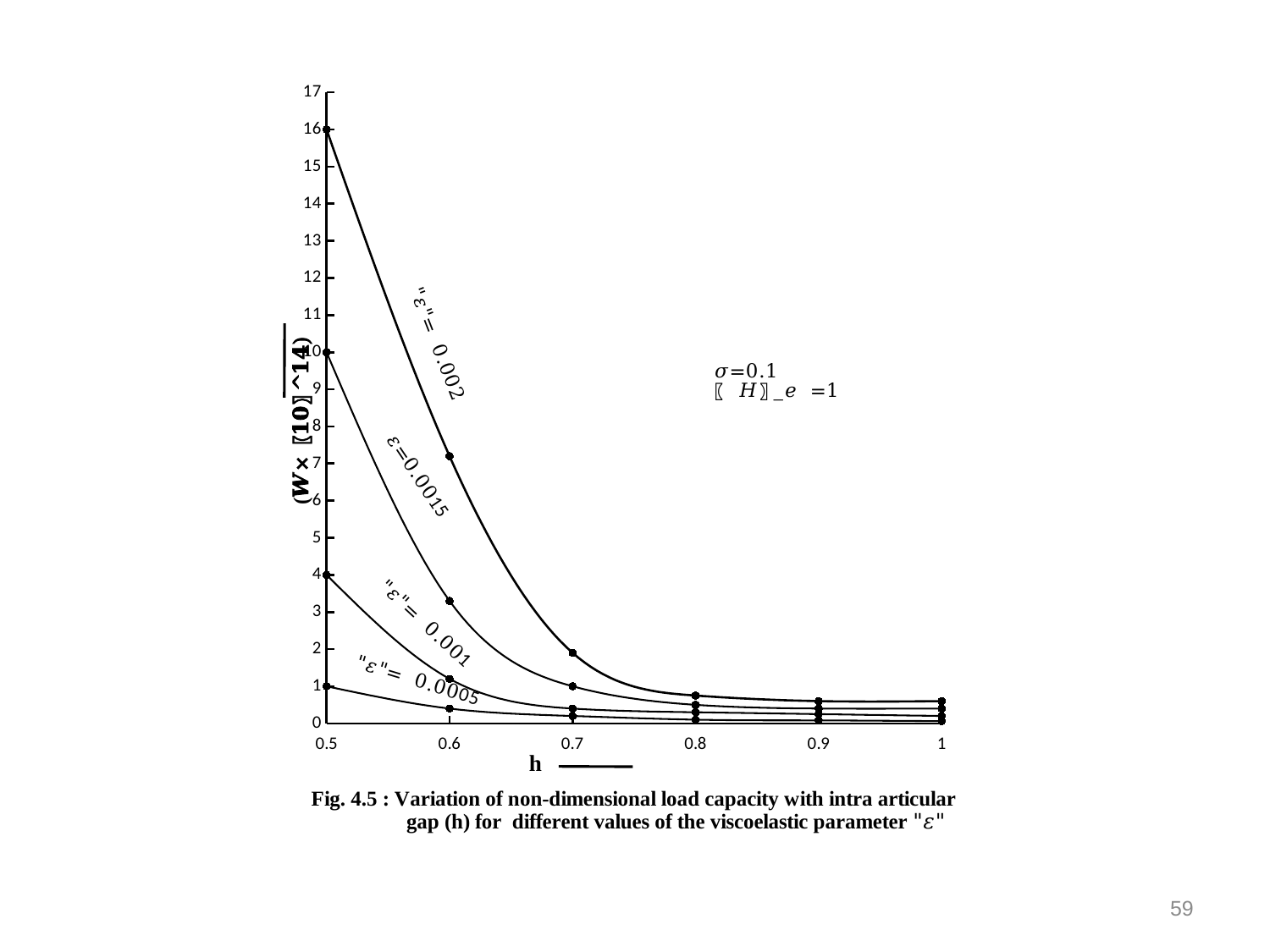
What is the value of the ε = 0.002 curve at h = 0.5? 16 Is the value of the ε = 0.002 curve at h = 0.6 greater or less than 5? greater At h = 0.6, which curve has the larger value, ε = 0.002 or ε = 0.001? ε = 0.002 Which curve has the highest value at h = 0.5? ε = 0.002 How many h values are marked along the x axis? 6 Do the curves rise or fall as h increases from 0.5 to 1? fall What is the value of the ε = 0.0015 curve at h = 0.5? 10 What is the value of the ε = 0.0005 curve at h = 0.5? 1 What kind of chart is shown on the slide? line chart Which curve has the lowest value at h = 0.5? ε = 0.0005 Is the value of the ε = 0.0015 curve at h = 0.6 greater or less than 5? less How many curves (values of ε) are plotted on the chart? 4